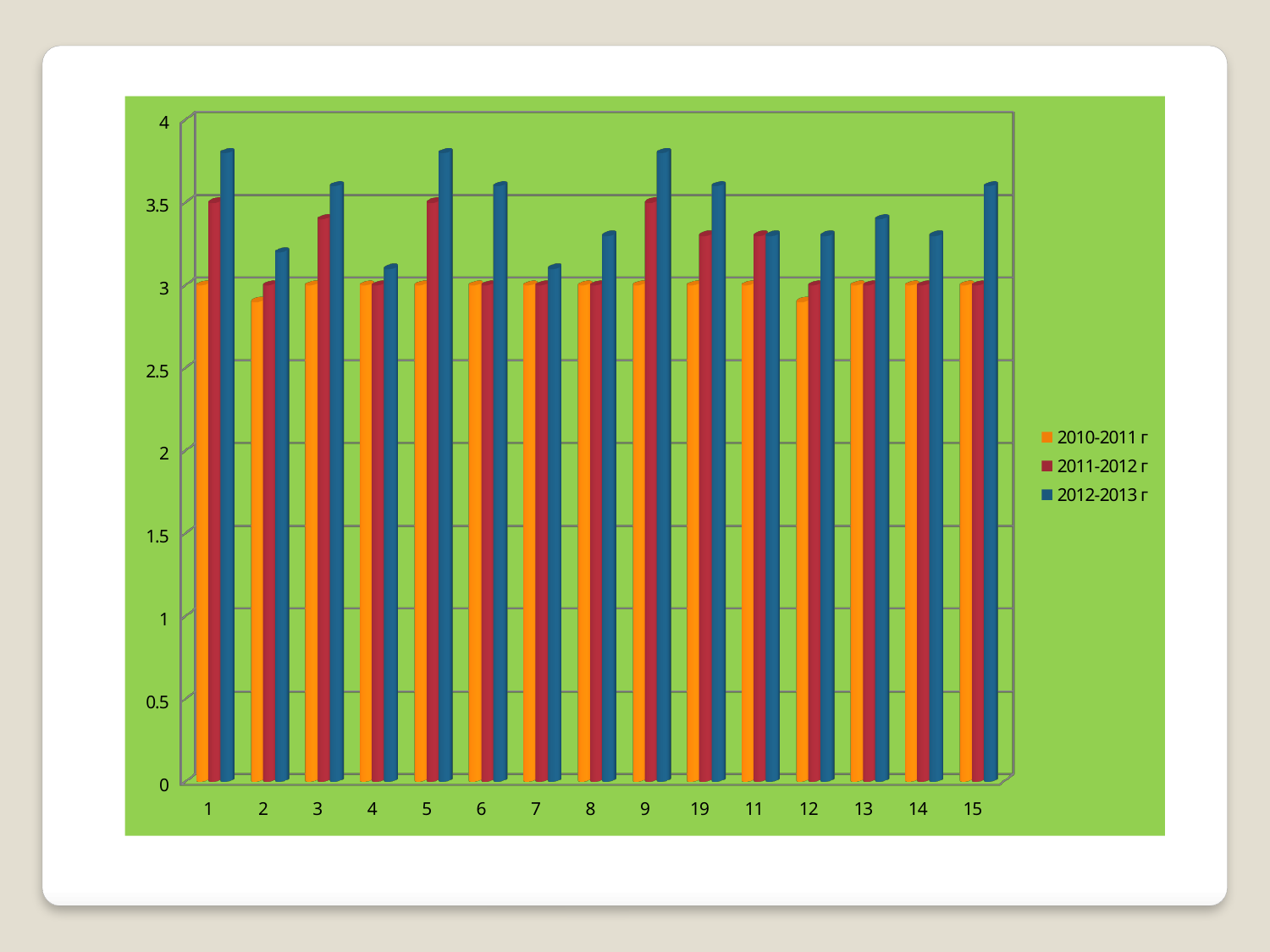
Which series is shown in blue according to the legend? 2012-2013 г What is the value for category 1 in the 2010-2011 г series? 3 Is the value for category 4 in the 2012-2013 г series greater or less than 3.5? less For category 5, which series has the larger value: 2010-2011 г or 2011-2012 г? 2011-2012 г What kind of chart is shown on the slide? bar chart Is the value for category 1 in the 2012-2013 г series greater or less than 3.5? greater For category 1, which series has the larger value: 2010-2011 г or 2012-2013 г? 2012-2013 г How many series does the legend list? 3 For category 3, which series has the highest value? 2012-2013 г Is the value for category 2 in the 2010-2011 г series greater or less than 3? less How many categories are shown along the x axis? 15